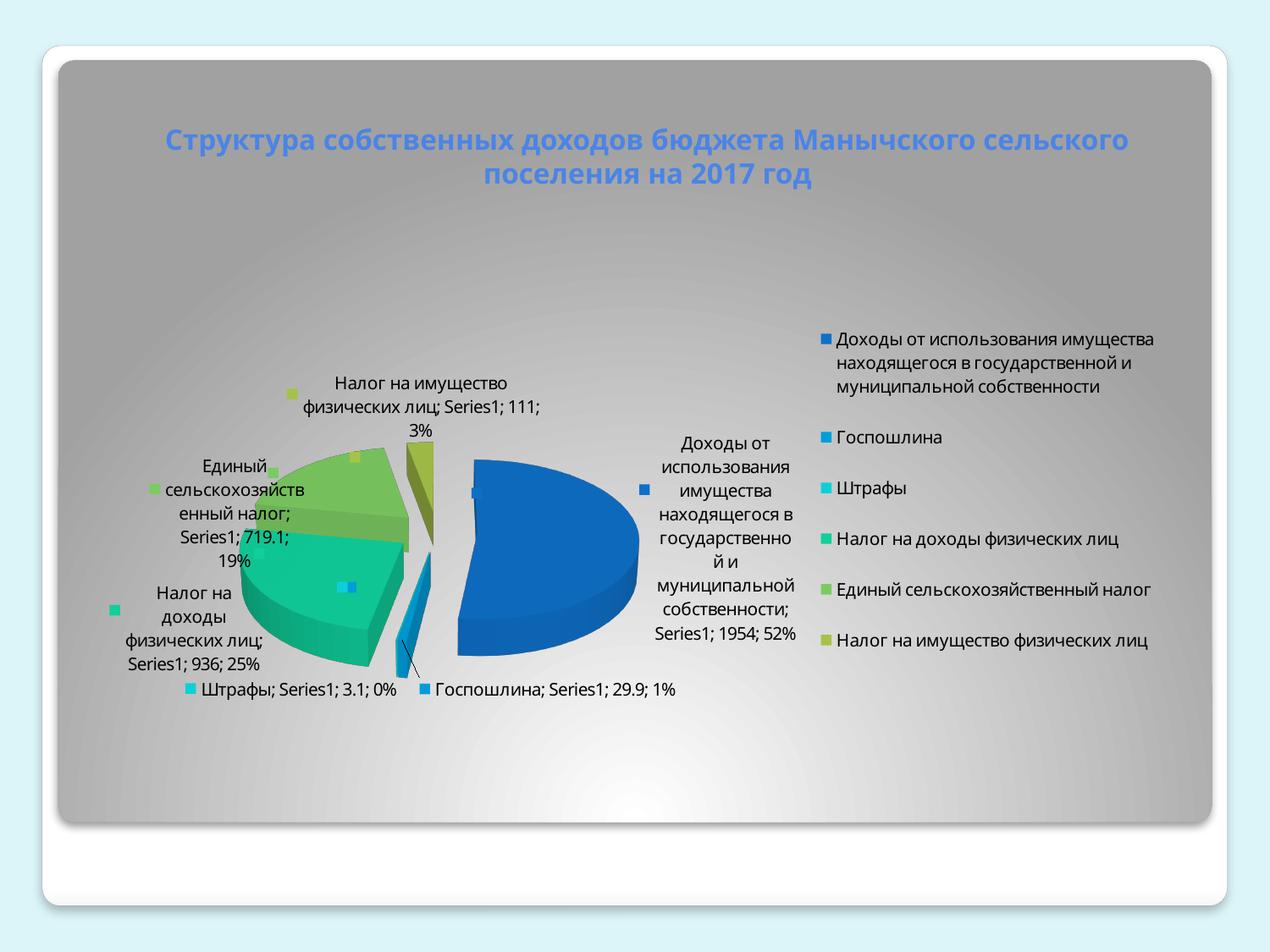
Which category has the smallest slice of the pie? Штрафы What is the value for Штрафы? 3.1 What is the value for Единый сельскохозяйственный налог? 719.1 Which is larger, the value for Единый сельскохозяйственный налог or the value for Налог на доходы физических лиц? Налог на доходы физических лиц What is the value for Налог на доходы физических лиц? 936 How many categories does the legend list? 6 What percentage share of the pie does Доходы от использования имущества находящегося в государственной и муниципальной собственности have? 52% What is the value for Госпошлина? 29.9 Which category has the largest slice of the pie? Доходы от использования имущества находящегося в государственной и муниципальной собственности What is the difference between the values for Налог на доходы физических лиц and Налог на имущество физических лиц? 825 What percentage share of the pie does Налог на имущество физических лиц have? 3% What kind of chart is shown on the slide? Pie chart